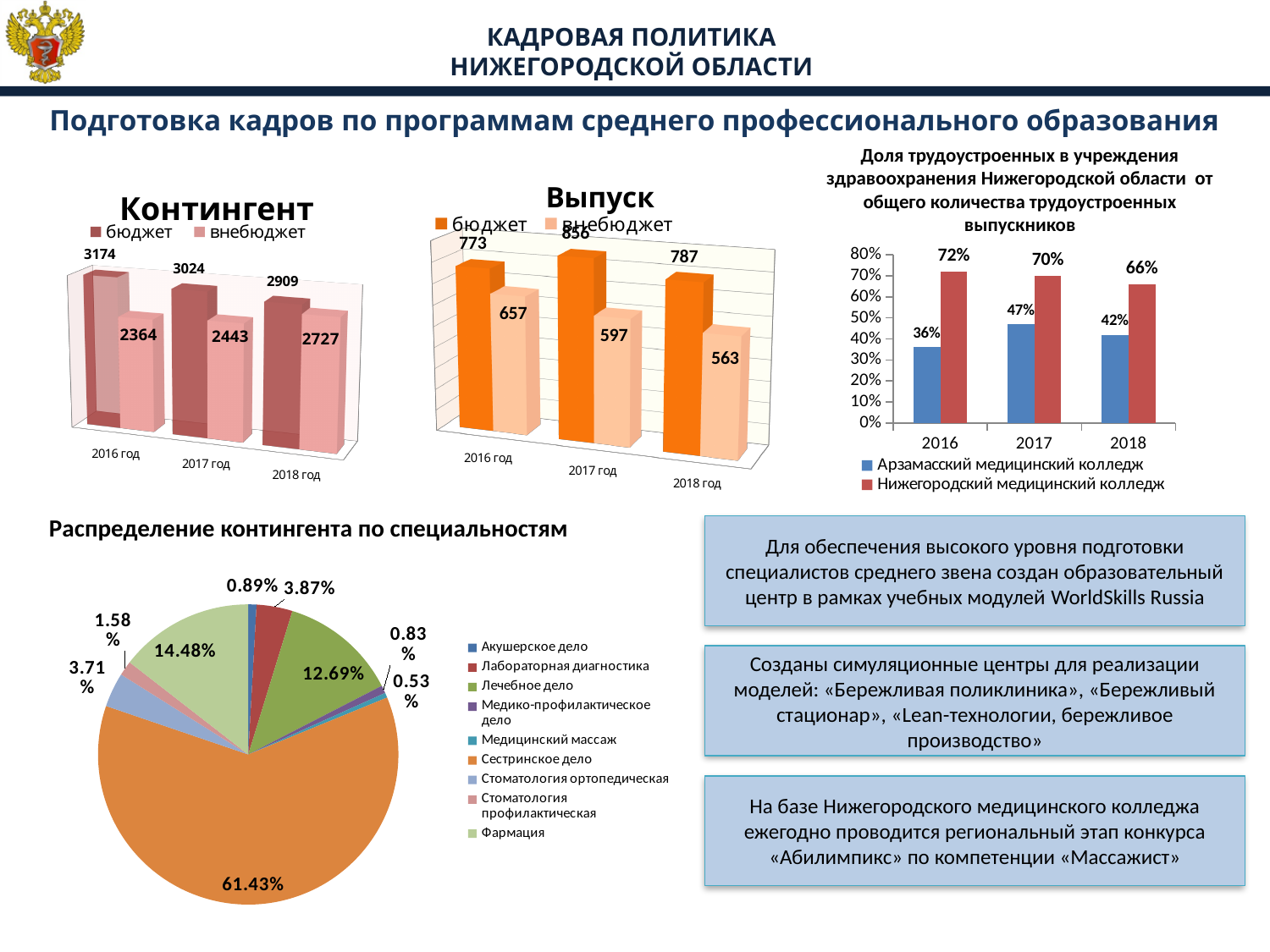
In the 'Доля трудоустроенных' chart, which is larger in 2018: Арзамасский медицинский колледж or Нижегородский медицинский колледж? Нижегородский медицинский колледж In the 'Выпуск' chart, which year has the highest бюджет value? 2017 год In the 'Контингент' chart, what is the value for бюджет in 2016 год? 3174 In the pie chart 'Распределение контингента по специальностям', which specialty has the smallest share? Медицинский массаж What kind of chart is 'Распределение контингента по специальностям'? pie chart In the 'Контингент' chart, what is the difference between бюджет and внебюджет in 2017 год? 581 In the pie chart 'Распределение контингента по специальностям', what share does Сестринское дело have? 61.43% In the 'Выпуск' chart, what is the value for внебюджет in 2018 год? 563 In the 'Доля трудоустроенных' chart, what is the value for Арзамасский медицинский колледж in 2017? 47% In the 'Выпуск' chart, do the внебюджет values rise or fall from 2016 год to 2018 год? fall In the 'Контингент' chart, what is the value for внебюджет in 2018 год? 2727 In the 'Доля трудоустроенных' chart, how many series does the legend list? 2